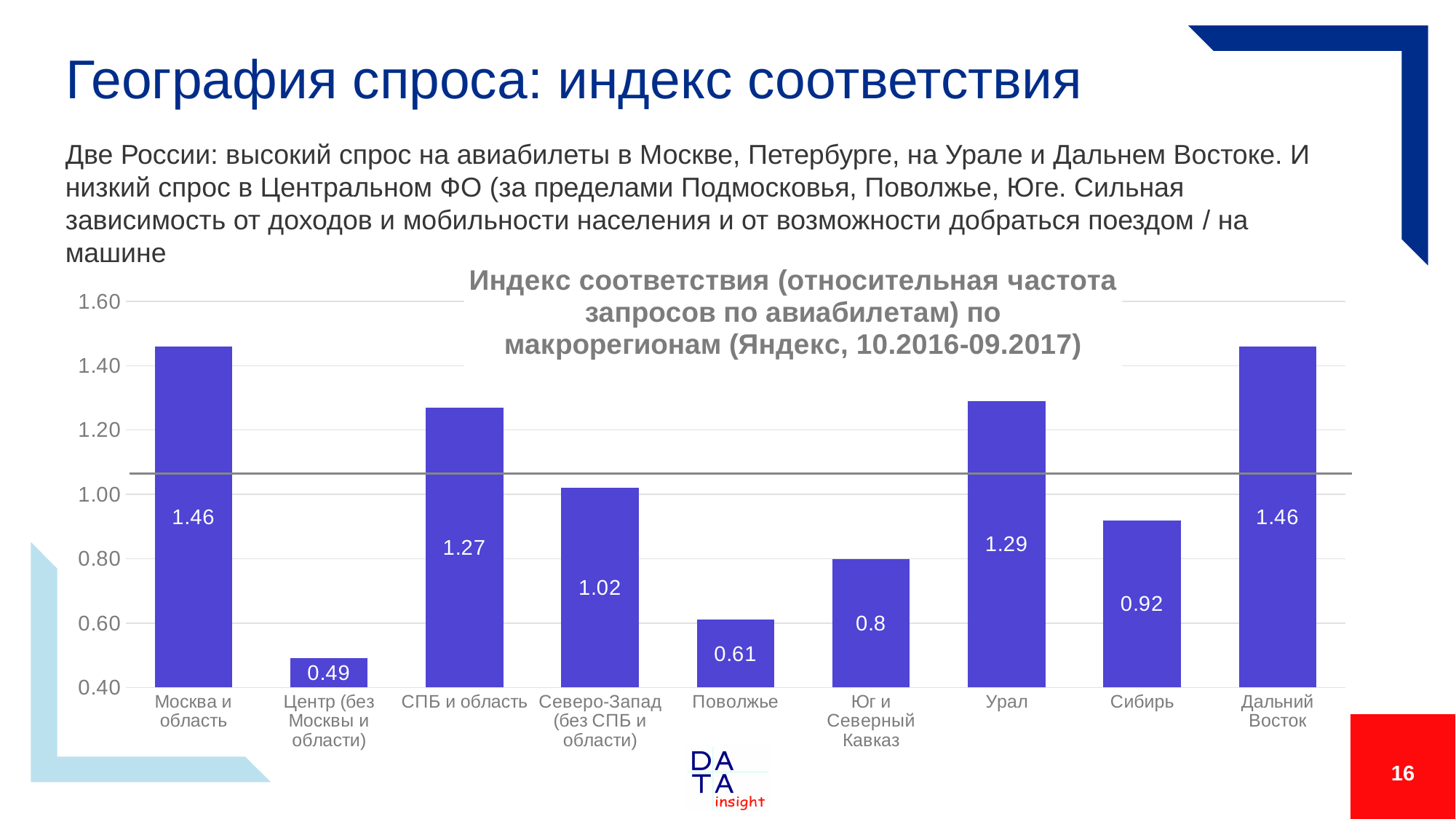
What is the index value for Сибирь? 0.92 What type of chart is shown on the slide? bar chart What is the lowest value shown on the vertical axis? 0.40 What is the difference between the index values for Москва и область and Дальний Восток? 0 What is the index value for Урал? 1.29 How many regions are shown on the chart? 9 Which region has the lowest index value? Центр (без Москвы и области) What is the index value for Юг и Северный Кавказ? 0.8 Is the index value for Урал greater or less than 1.20? greater What is the difference between the index values for СПБ и область and Северо-Запад (без СПБ и области)? 0.25 What is the index value for Центр (без Москвы и области)? 0.49 Which has a higher index value, Поволжье or Сибирь? Сибирь